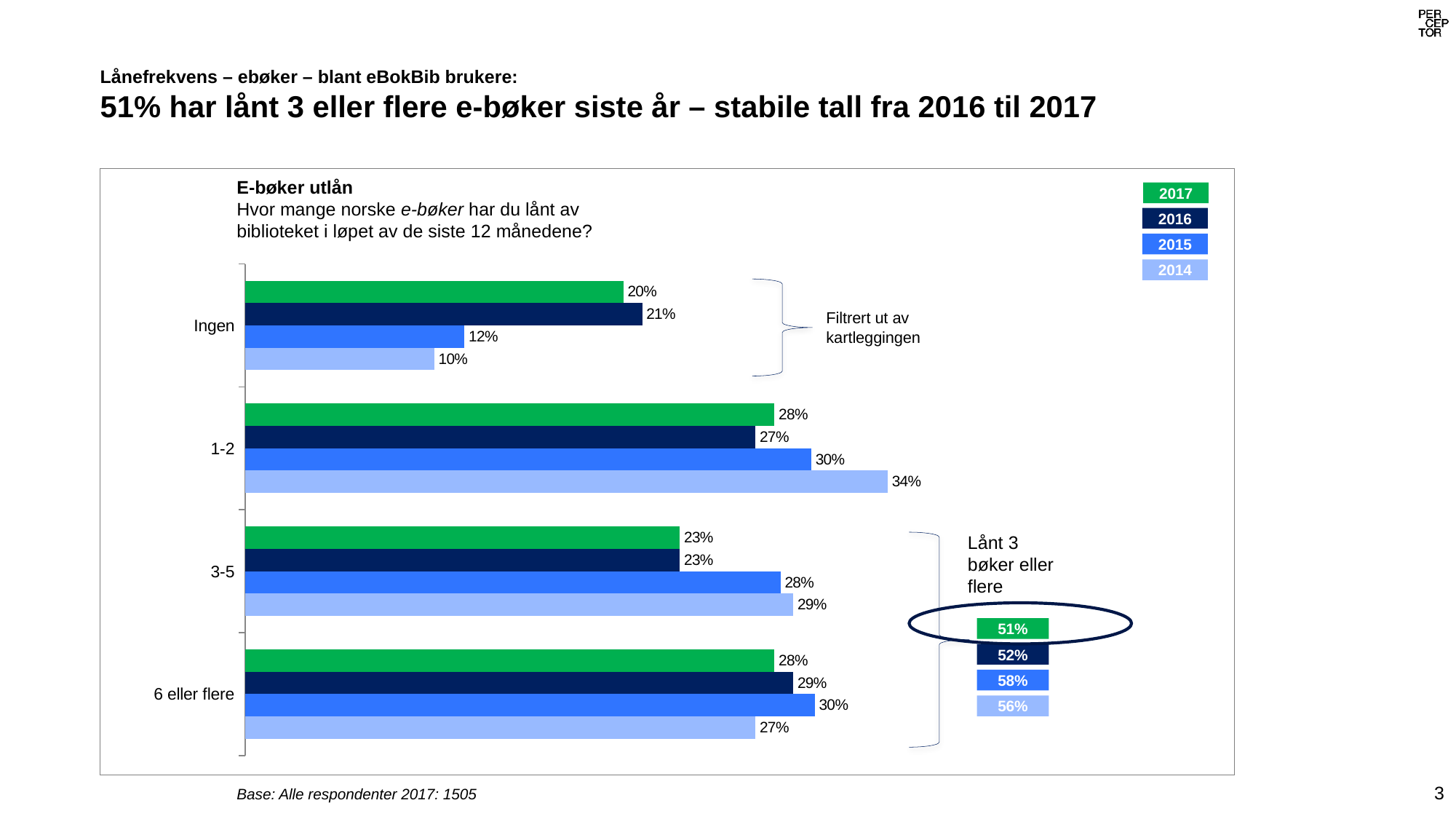
How many series does the legend list? 4 Which is larger in the "3-5" category: the 2015 value or the 2017 value? 2015 Which year has the lowest value in the "Ingen" category? 2014 How many categories are shown on the y axis of the chart? 4 What is the title of the chart? E-bøker utlån What kind of chart is shown on the slide? Bar chart What is the value for 2015 in the "6 eller flere" category? 30% What is the difference between the 2016 and 2015 values in the "Ingen" category? 9% What is the 2017 value shown in the "Lånt 3 bøker eller flere" summary? 51% What is the value for 2014 in the "Ingen" category? 10% Which year has the highest value in the "1-2" category? 2014 What is the value for 2017 in the "1-2" category? 28%